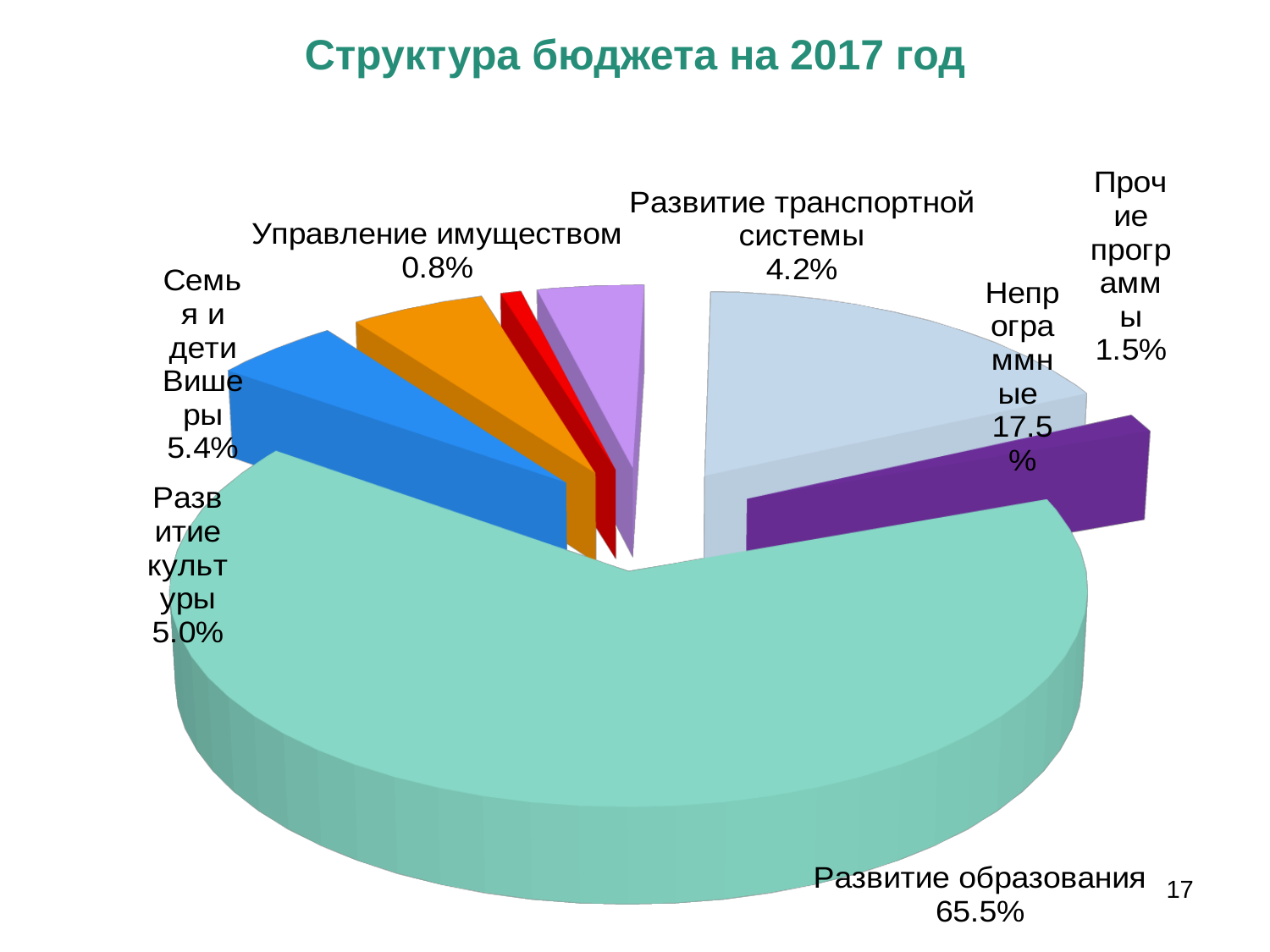
What share of the budget goes to Прочие программы? 1.5% What share of the budget is Непрограммные? 17.5% How many slices does the pie chart have? 7 What share of the budget goes to Управление имуществом? 0.8% What kind of chart is shown on the slide? pie chart What is the title of the chart? Структура бюджета на 2017 год Which is larger, the share for Семья и дети Вишеры or the share for Развитие культуры? Семья и дети Вишеры Which category has the largest share of the budget? Развитие образования What is the difference between the shares of Развитие образования and Непрограммные? 48.0% Which category has the smallest share of the budget? Управление имуществом What share of the budget goes to Развитие транспортной системы? 4.2% What share of the budget goes to Развитие образования? 65.5%